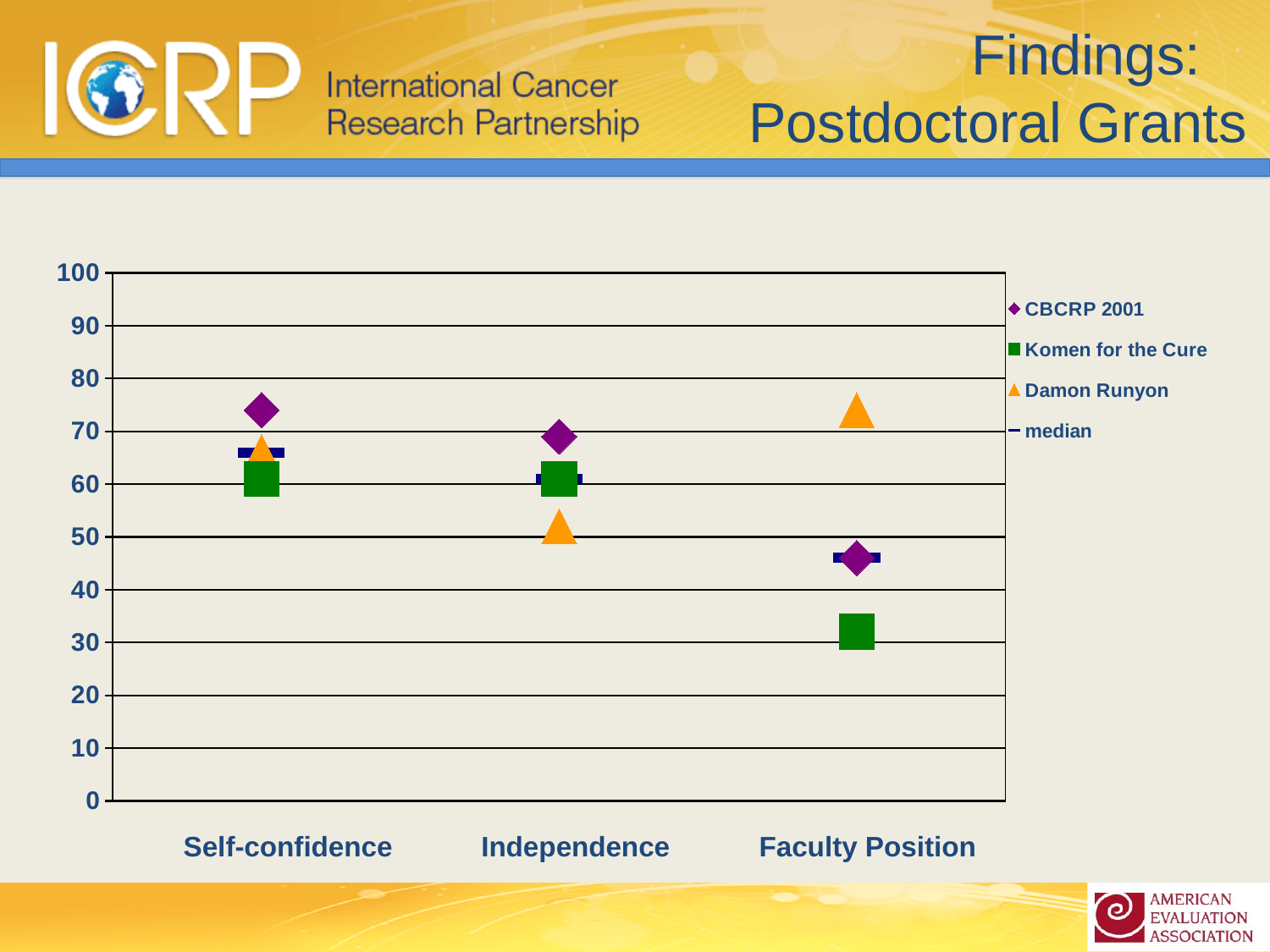
In which category is the Komen for the Cure value lowest? Faculty Position Is the Komen for the Cure value for Faculty Position greater or less than 40? less Is the Damon Runyon value for Independence greater or less than 60? less In which category is the Damon Runyon value highest? Faculty Position Is the Komen for the Cure value for Self-confidence greater or less than 50? greater How many categories are shown on the x axis? 3 For Faculty Position, which is larger: the CBCRP 2001 value or the Komen for the Cure value? CBCRP 2001 For Independence, which is larger: the CBCRP 2001 value or the Damon Runyon value? CBCRP 2001 How many series does the legend list? 4 Do the CBCRP 2001 values rise or fall from Self-confidence to Faculty Position? fall